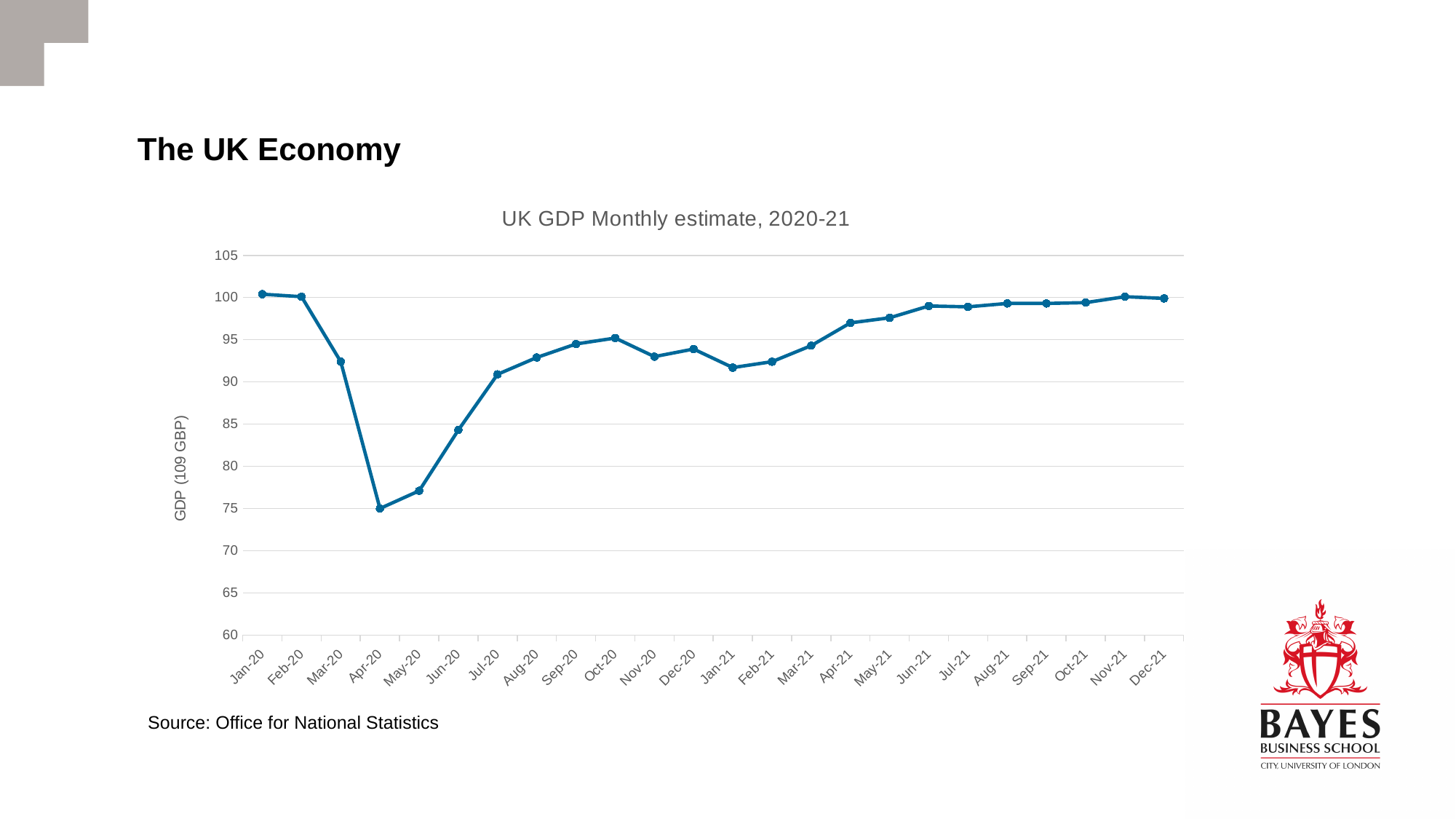
Is the value for Jan-21 greater or less than 90? greater Do the values rise or fall from Apr-20 to Jul-20? Rise What is the title of the chart? UK GDP Monthly estimate, 2020-21 Is the value for Mar-20 greater or less than 90? greater What is the label on the vertical axis of the chart? GDP (109 GBP) Is the value for Dec-21 greater or less than 95? greater Which month has the lowest GDP value on the chart? Apr-20 Which is larger, the value for Oct-20 or the value for Jan-21? Oct-20 What kind of chart is shown on the slide? Line chart Which is larger, the value for Mar-20 or the value for Apr-20? Mar-20 How many monthly data points are plotted on the chart? 24